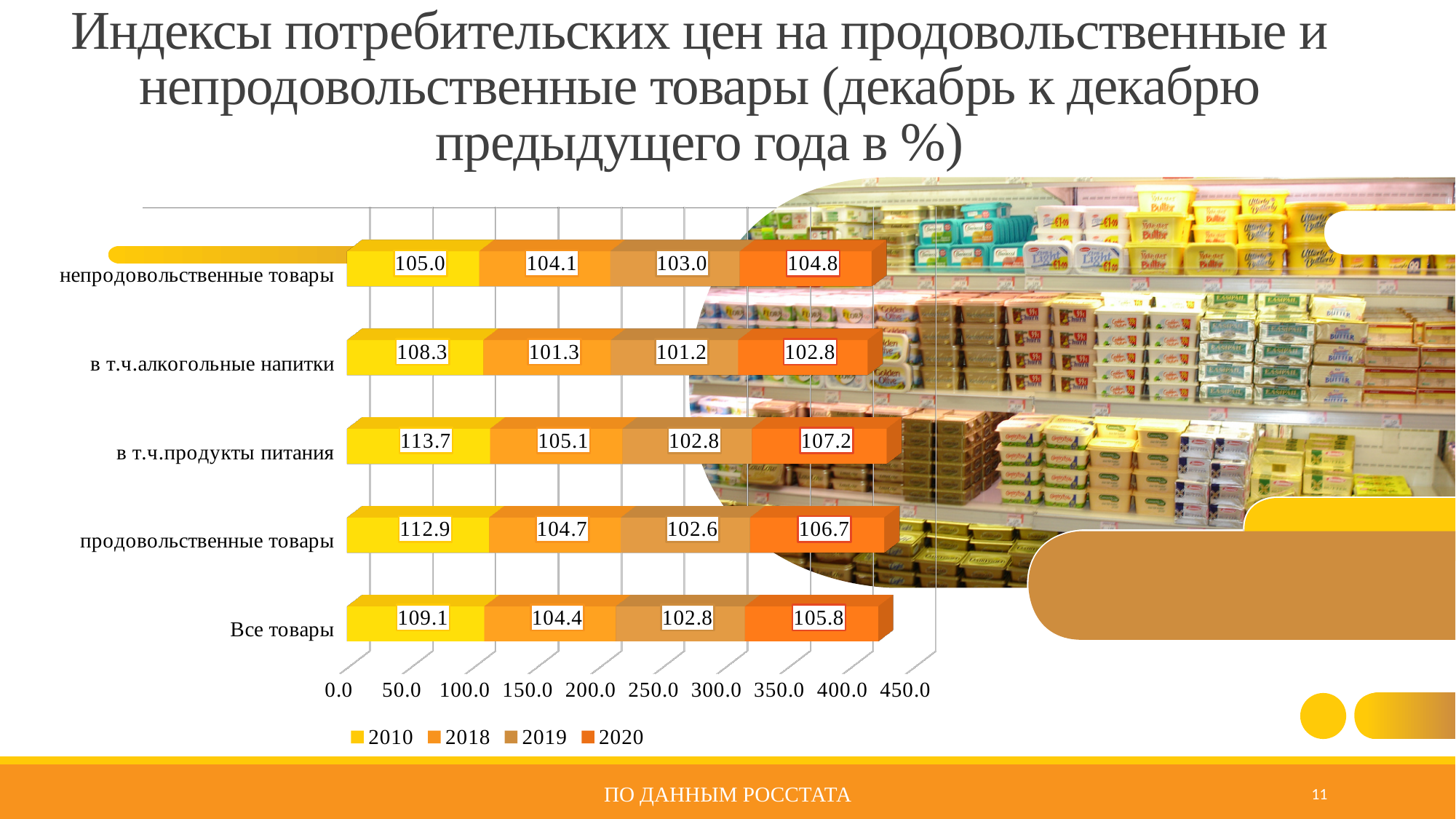
What is the 2020 value for 'Все товары'? 105.8 What is the total of the stacked bar for 'Все товары'? 422.1 Which is larger: the 2018 value for 'продовольственные товары' or the 2018 value for 'в т.ч.алкогольные напитки'? продовольственные товары How many series does the legend list? 4 Which series is shown in the yellow colour in the legend? 2010 What is the difference between the 2020 values for 'в т.ч.продукты питания' and 'непродовольственные товары'? 2.4 Which category has the highest 2010 value? в т.ч.продукты питания What type of chart is shown on the slide? stacked bar chart Which category has the lowest 2019 value? в т.ч.алкогольные напитки How many categories are plotted on the chart? 5 What is the 2019 value for 'непродовольственные товары'? 103.0 What is the 2010 value for 'в т.ч.продукты питания'? 113.7